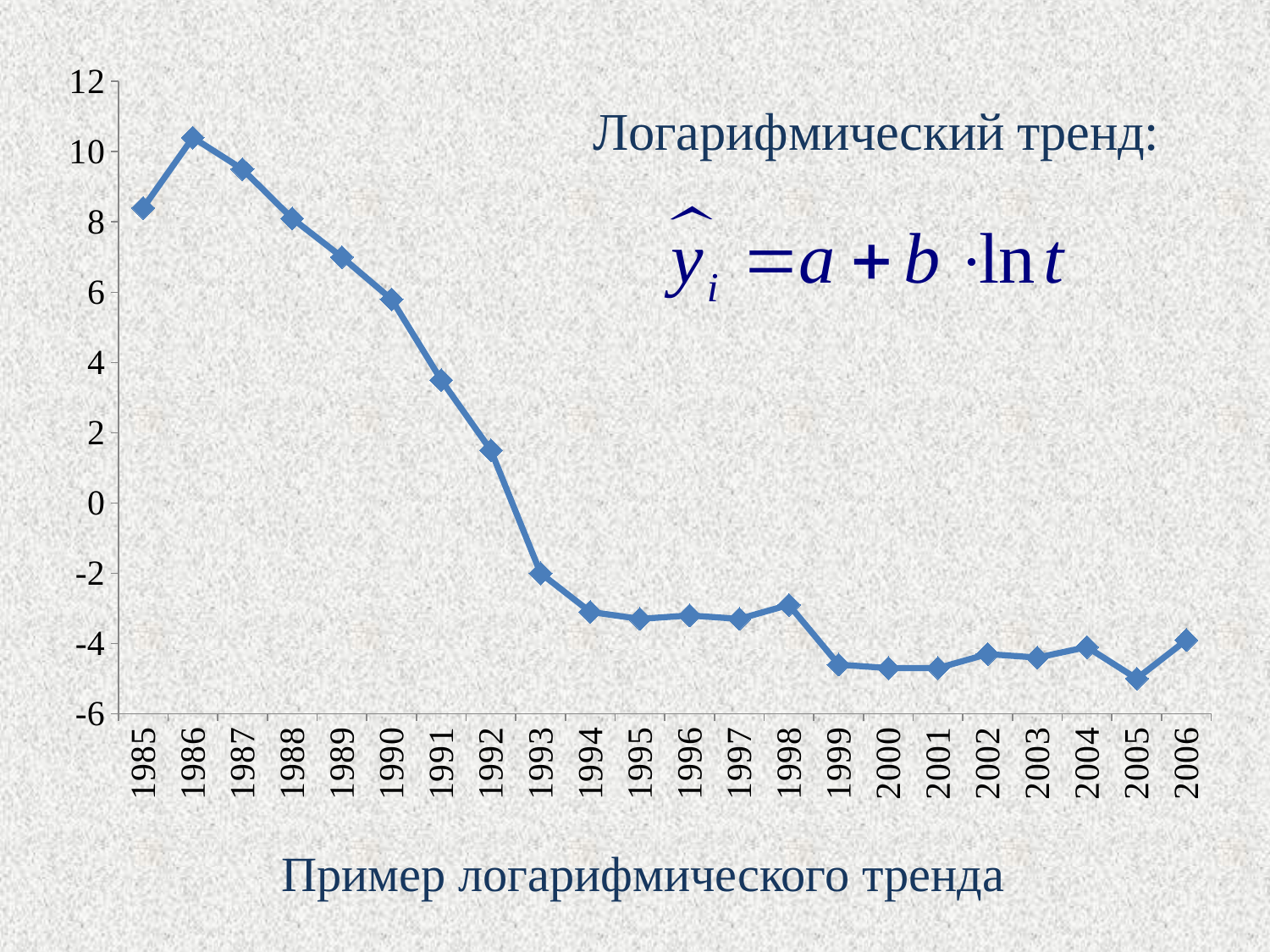
In which year does the line reach its lowest value? 2005 Is the value for 2005 greater or less than -4? less Is the value for 1992 greater or less than 0? greater Is the value for 1989 greater or less than 6? greater Overall, do the values rise or fall from 1986 to 2005? fall How many years are plotted on the x axis of the chart? 22 Which year has the larger value, 1987 or 1988? 1987 What kind of chart is shown on the slide? line chart Which year has the larger value, 1993 or 1999? 1993 In which year does the line reach its highest value? 1986